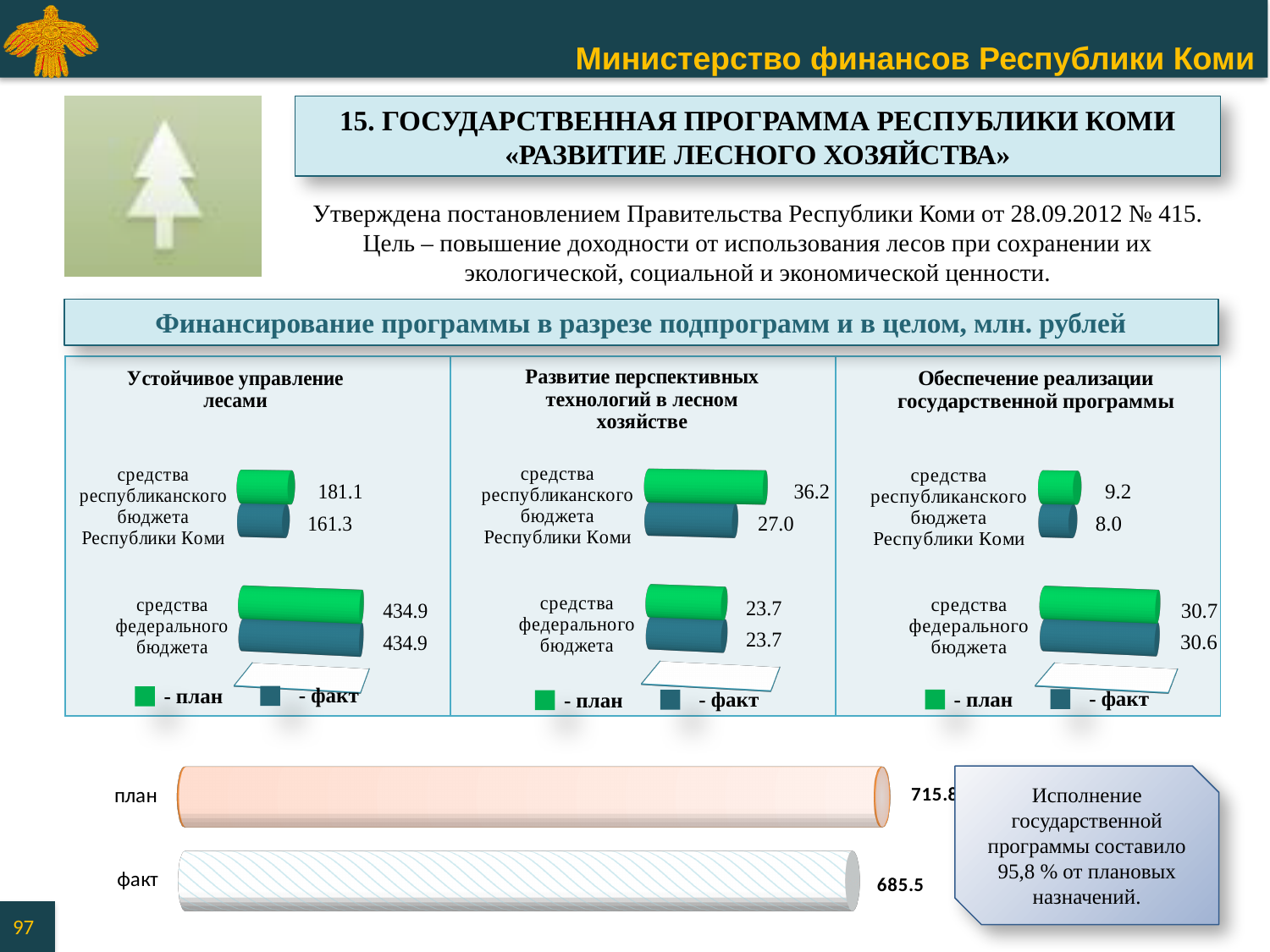
In the chart 'Развитие перспективных технологий в лесном хозяйстве', what is the difference between the plan and the fact for средства республиканского бюджета Республики Коми? 9.2 In the chart 'Обеспечение реализации государственной программы', what is the actual value (факт) for средства республиканского бюджета Республики Коми? 8.0 In the chart 'Устойчивое управление лесами', what is the actual value (факт) for средства федерального бюджета? 434.9 In the chart 'Развитие перспективных технологий в лесном хозяйстве', what is the planned value (план) for средства республиканского бюджета Республики Коми? 36.2 What kind of chart is the bottom chart showing план and факт for the whole programme? bar chart In the chart 'Обеспечение реализации государственной программы', what is the planned value (план) for средства федерального бюджета? 30.7 In the chart 'Развитие перспективных технологий в лесном хозяйстве', which is larger: the plan for средства республиканского бюджета or the plan for средства федерального бюджета? средства республиканского бюджета In the chart 'Устойчивое управление лесами', what is the planned value (план) for средства республиканского бюджета Республики Коми? 181.1 In the chart 'Устойчивое управление лесами', what is the actual value (факт) for средства республиканского бюджета Республики Коми? 161.3 In the bottom chart showing план and факт for the whole programme, what is the value for факт? 685.5 In the chart 'Обеспечение реализации государственной программы', how many series does the legend list? 2 In the chart 'Устойчивое управление лесами', what is the difference between the plan and the fact for средства республиканского бюджета Республики Коми? 19.8